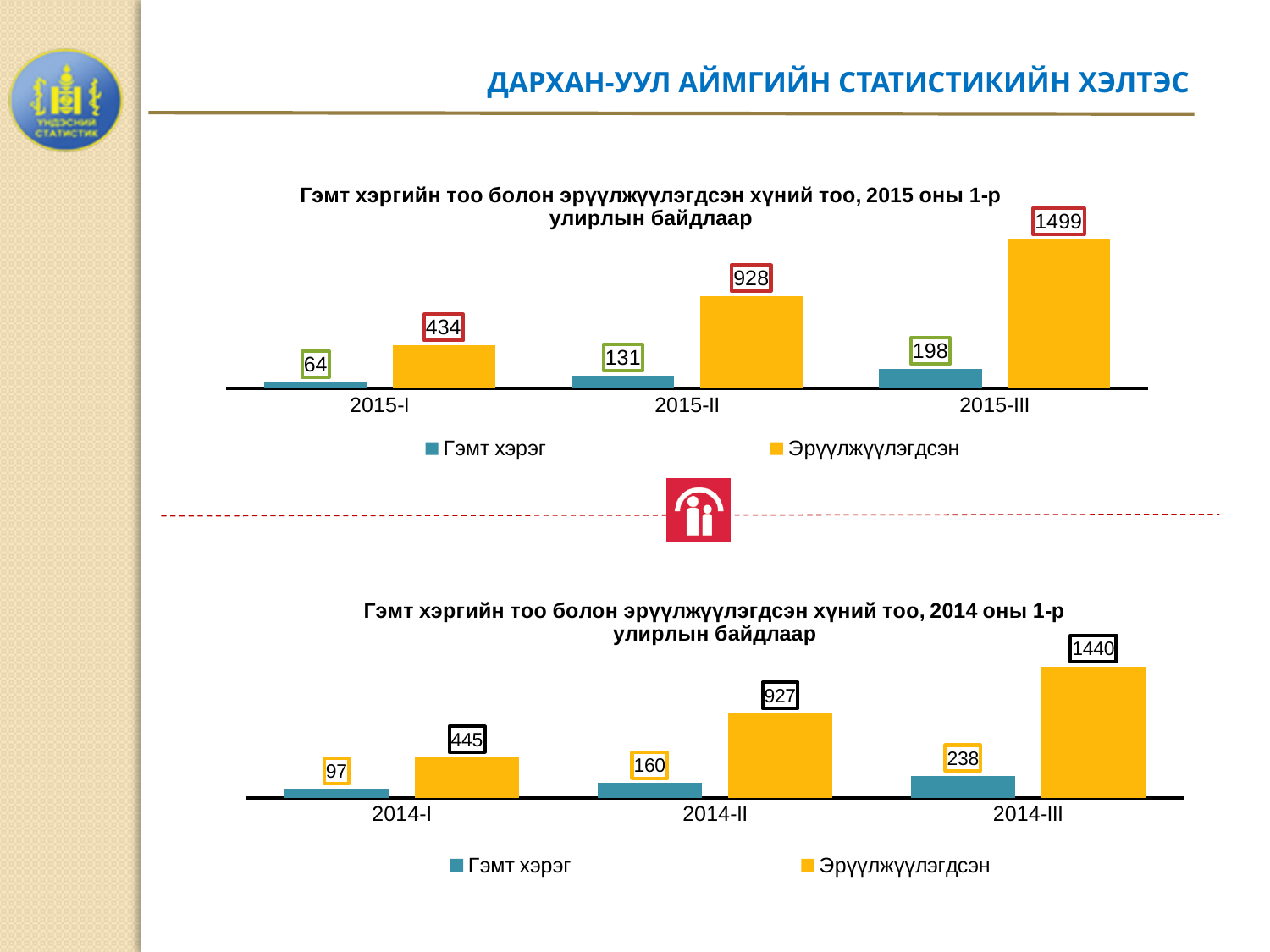
What type of chart is the top chart (2015)? Bar chart In the bottom chart (2014), what is the value of Эрүүлжүүлэгдсэн for 2014-II? 927 In the top chart (2015), what is the difference between the Эрүүлжүүлэгдсэн values for 2015-II and 2015-I? 494 In the bottom chart (2014), what is the value of Гэмт хэрэг for 2014-III? 238 How many categories are shown on the x axis of the top chart (2015)? 3 In the bottom chart (2014), which category has the lowest Эрүүлжүүлэгдсэн value? 2014-I In the top chart (2015), what is the value of Эрүүлжүүлэгдсэн for 2015-III? 1499 How many series does the legend of the bottom chart (2014) list? 2 In the bottom chart (2014), which is larger: Гэмт хэрэг for 2014-III or Эрүүлжүүлэгдсэн for 2014-I? Эрүүлжүүлэгдсэн for 2014-I In the top chart (2015), which category has the highest Гэмт хэрэг value? 2015-III In the bottom chart (2014), what is the difference between the Гэмт хэрэг values for 2014-II and 2014-I? 63 In the top chart (2015), what is the value of Гэмт хэрэг for 2015-I? 64